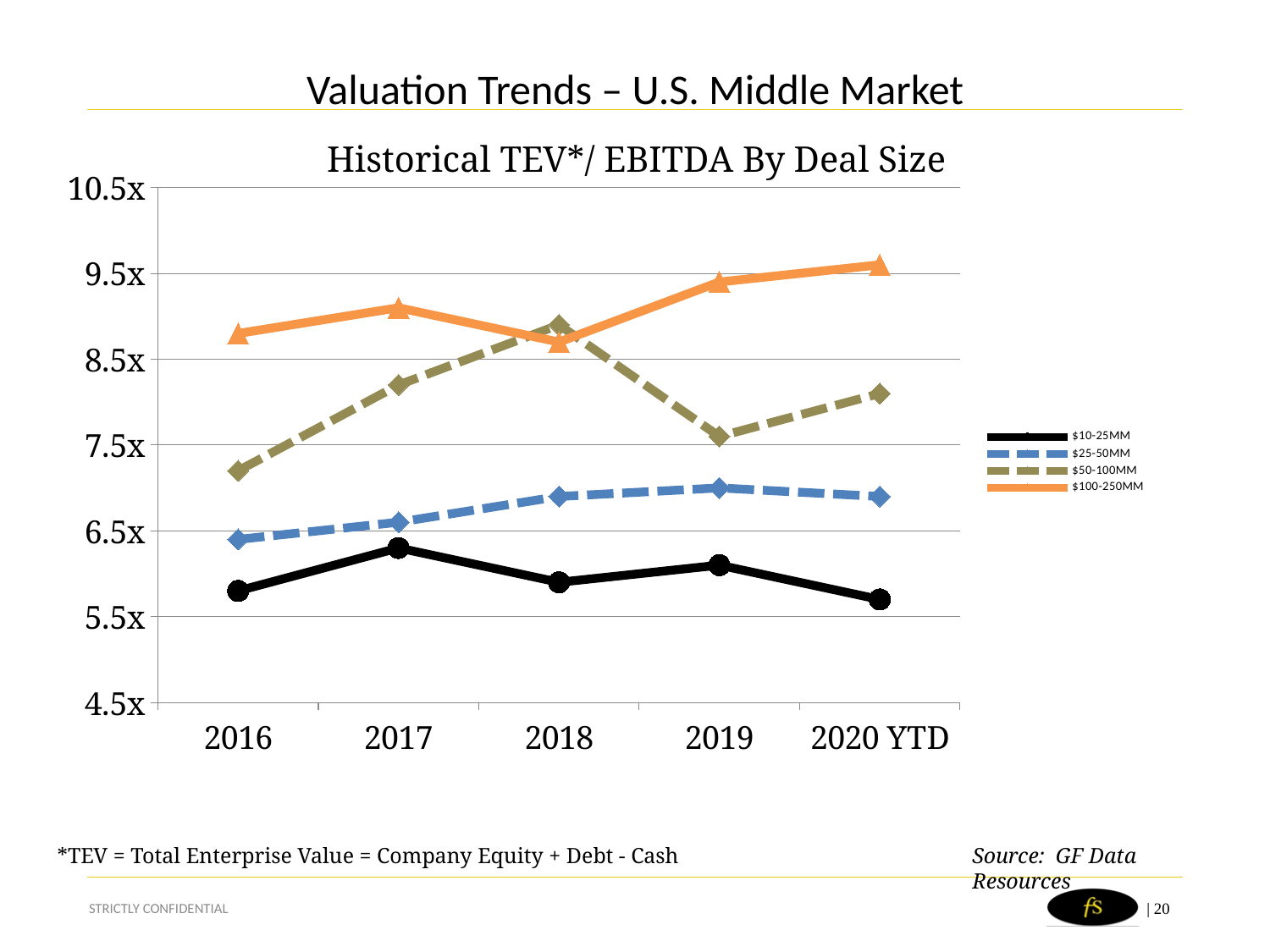
Is the $100-250MM value higher in 2016 or in 2020 YTD? 2020 YTD How many time periods are plotted along the x axis? 5 What is the title of the chart? Historical TEV*/ EBITDA By Deal Size Does the $100-250MM series rise or fall from 2018 to 2020 YTD? Rise Which deal size series has the lowest value in 2016? $10-25MM Is the value for $100-250MM in 2016 greater or less than 8.5x? greater What kind of chart is shown on the slide? Line chart Which deal size series has the highest value in 2020 YTD? $100-250MM Is the value for $50-100MM in 2016 greater or less than 7.5x? less Is the value for $10-25MM in 2020 YTD greater or less than 6.5x? less How many series does the legend list? 4